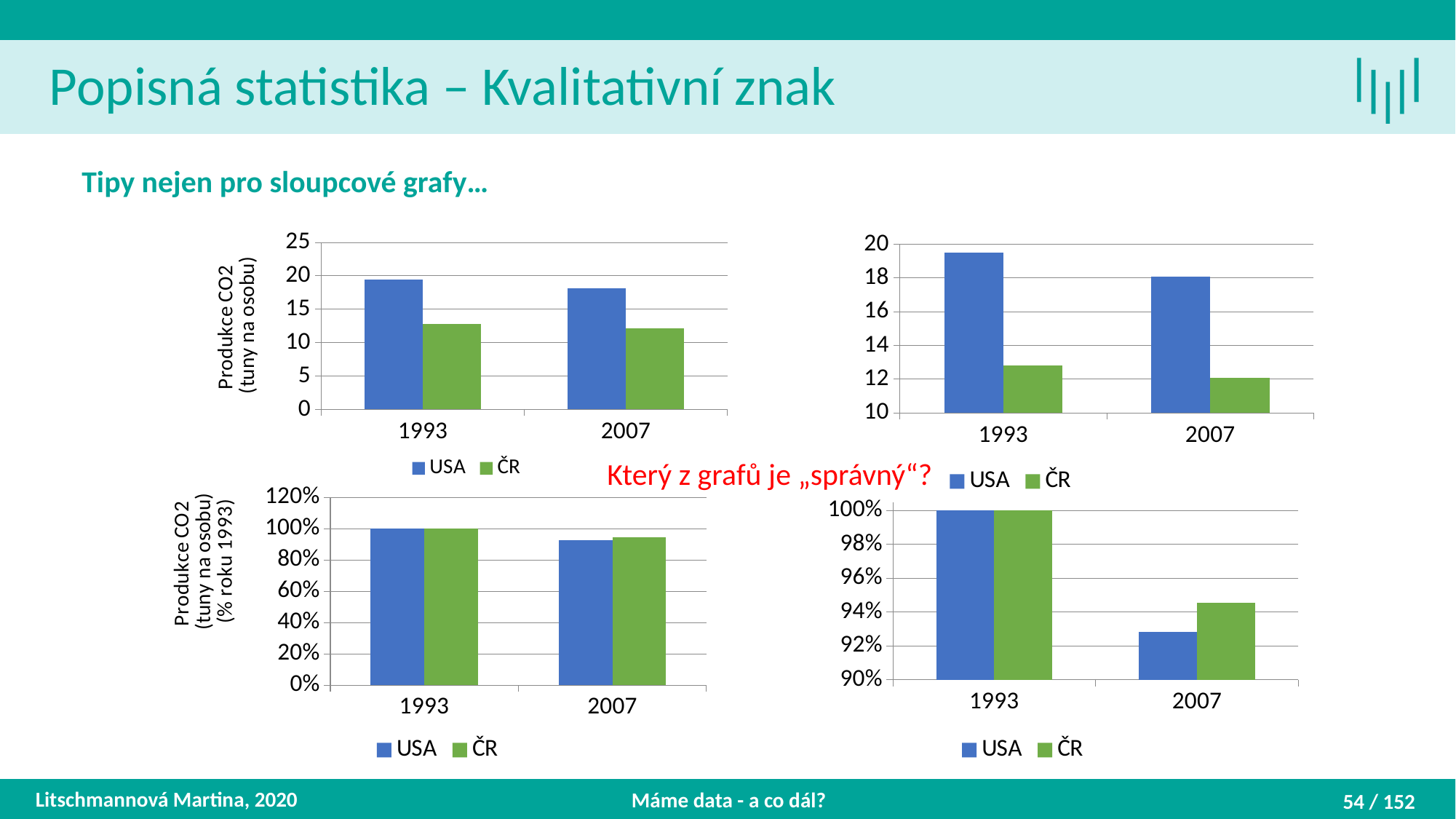
In the top-left chart, what kind of chart is shown? bar chart In the bottom-right chart, is the value for USA in 2007 greater or less than 94%? less In the top-left chart, which series is higher in 1993, USA or ČR? USA In the top-right chart, does the USA value rise or fall from 1993 to 2007? fall In the bottom-left chart, what is the value for USA in 1993? 100% In the top-left chart, is the value for USA in 1993 greater or less than 15? greater In the top-left chart, is the value for ČR in 2007 greater or less than 15? less How many categories are shown on the x axis of the bottom-left chart? 2 In the bottom-right chart, which series is higher in 2007, USA or ČR? ČR In the bottom-right chart, what is the value for ČR in 1993? 100% In the top-left chart, how many series does the legend list? 2